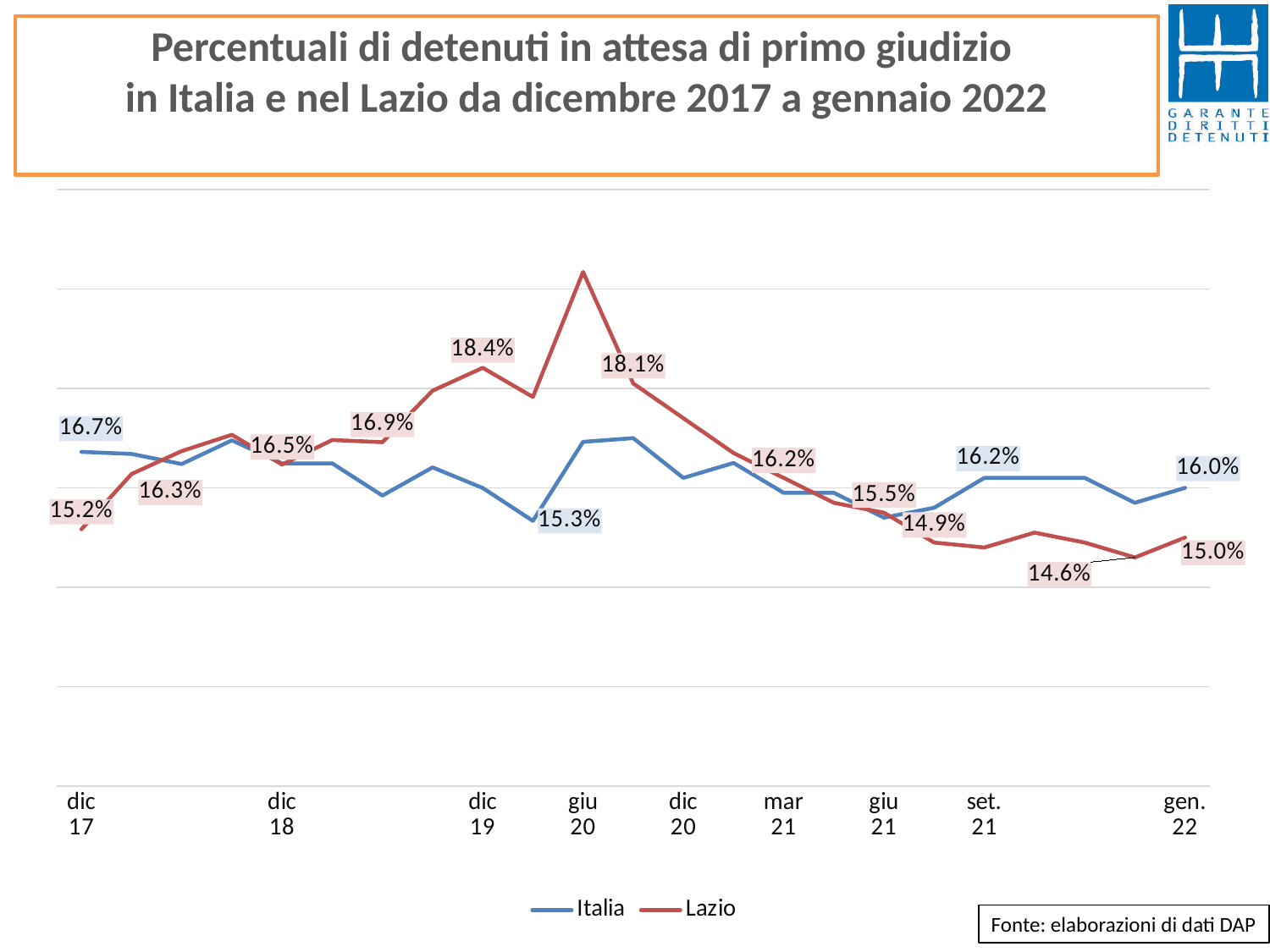
What is the highest labelled value for the Lazio series? 18.4% What is the value for Italia at dic 17? 16.7% What is the value for Italia at gen. 22? 16.0% What kind of chart is shown on the slide? line chart What is the value for Lazio at dic 17? 15.2% What is the lowest labelled value for the Lazio series? 14.6% How many series does the legend list? 2 What is the value for Italia at set. 21? 16.2% What is the value for Lazio at gen. 22? 15.0% What is the difference between the Italia and Lazio values at gen. 22? 1.0 percentage points Does the Lazio series rise or fall between giu 20 and set. 21? fall Which series has the higher value at dic 17, Italia or Lazio? Italia